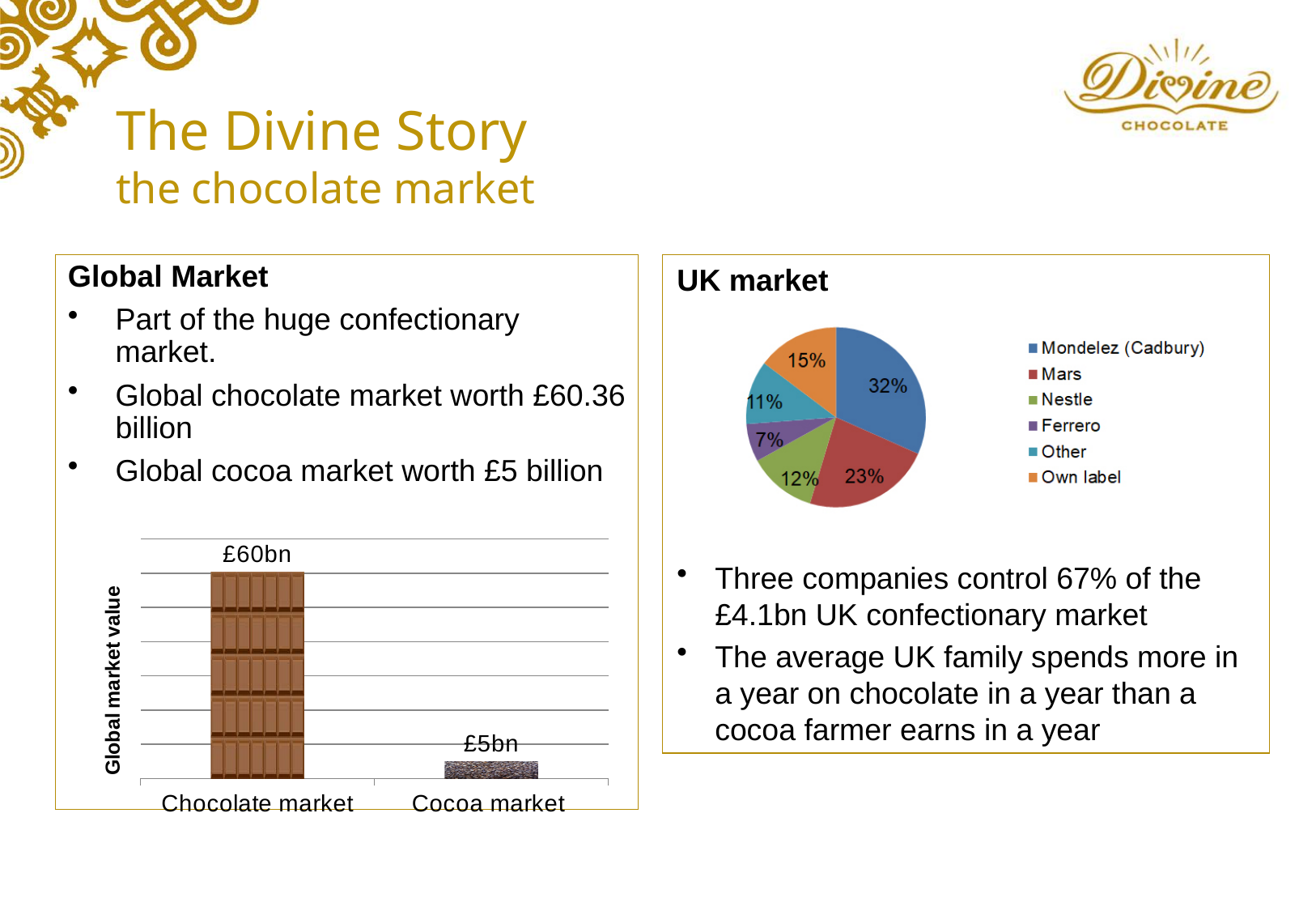
In the UK market pie chart, which company has the smallest share? Ferrero In the UK market pie chart, which is larger, the share for Nestle or the share for Own label? Own label In the UK market pie chart, how many entries does the legend list? 6 In the bar chart on the left, how many categories are shown? 2 In the UK market pie chart, what share does Ferrero have? 7% In the bar chart on the left, what is the value for the Chocolate market? £60bn In the UK market pie chart, what share does Mondelez (Cadbury) have? 32% In the UK market pie chart, which slice is the largest? Mondelez (Cadbury) What kind of chart is the chart on the left showing global market value? Bar chart In the UK market pie chart, what share does Mars have? 23% In the bar chart on the left, what is the value for the Cocoa market? £5bn In the bar chart on the left, what is the difference between the Chocolate market and the Cocoa market values? £55bn